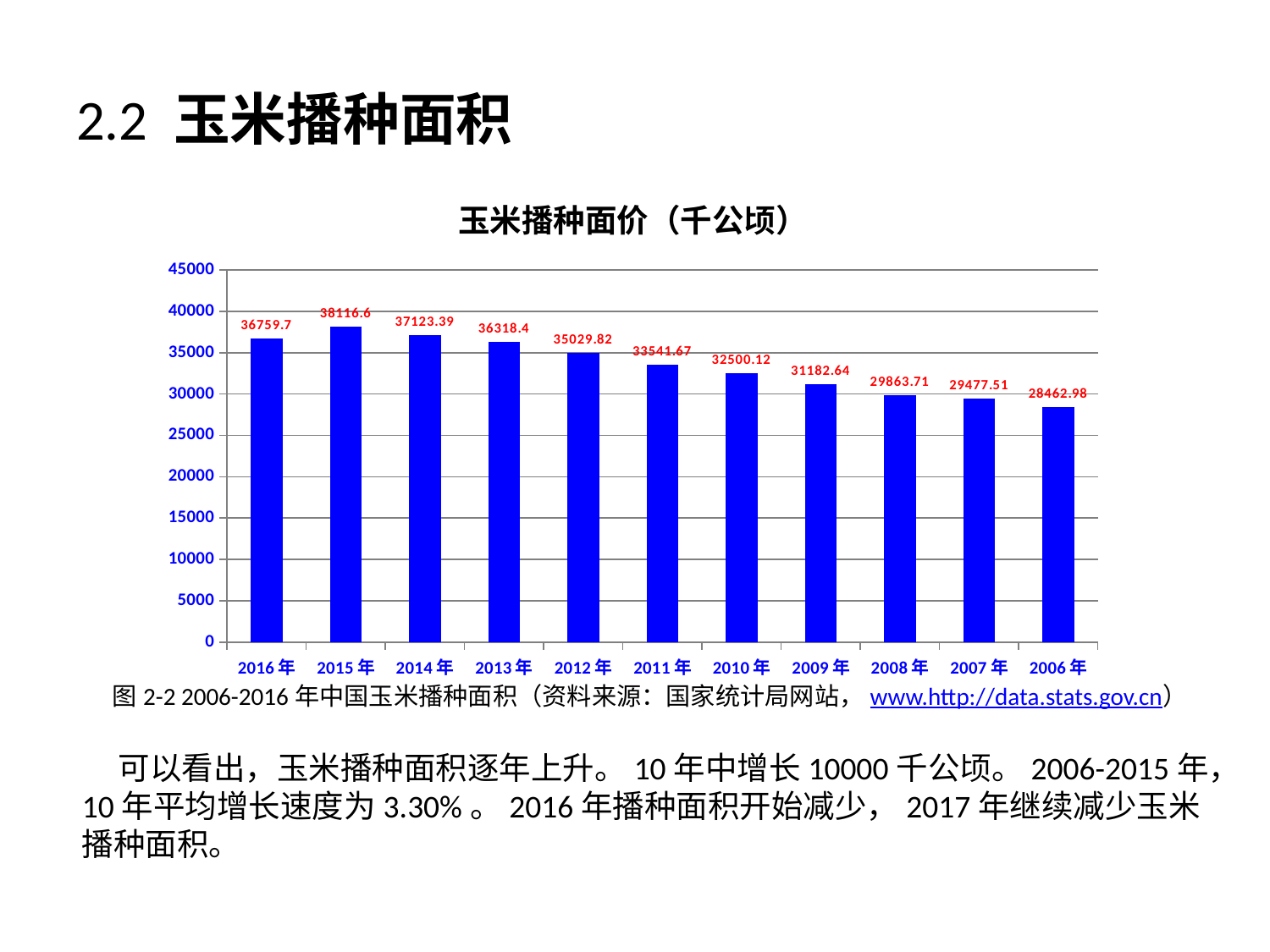
Which year has the lowest value? 2006年 What is the difference between the values for 2015年 and 2006年? 9653.62 What is the value for 2015年? 38116.6 How many years are shown on the x axis? 11 Which year has the highest value? 2015年 What is the value for 2006年? 28462.98 What is the difference between the values for 2016年 and 2015年? 1356.9 Which is larger, the value for 2014年 or the value for 2013年? 2014年 What is the title of the chart? 玉米播种面价（千公顷） Is the value for 2008年 greater or less than 30000? less What is the value for 2011年? 33541.67 What kind of chart is this? bar chart